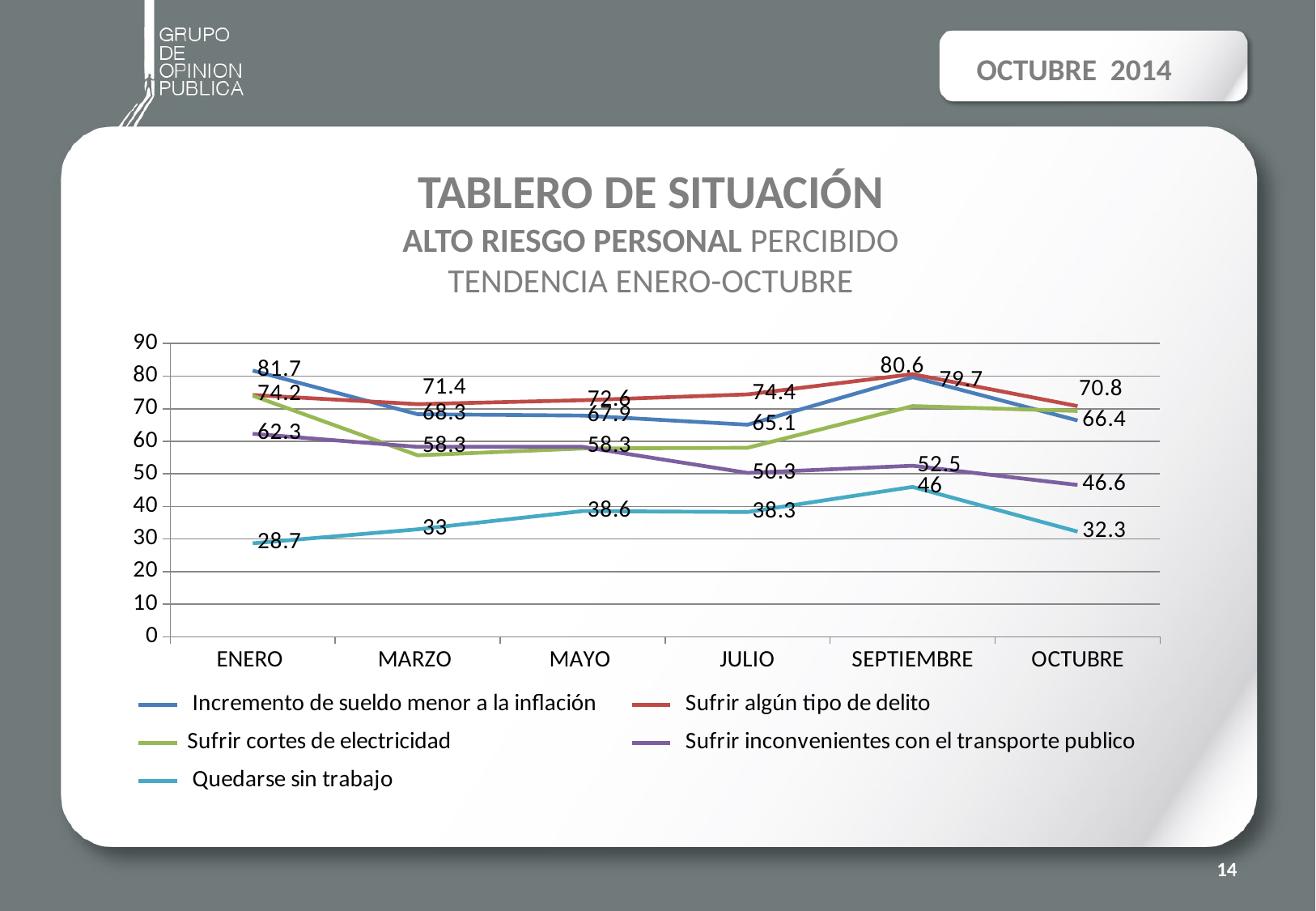
What kind of chart is shown on the slide? Line chart What is the value for Quedarse sin trabajo in SEPTIEMBRE? 46 In which month is Quedarse sin trabajo lowest? ENERO In JULIO, which is larger: Incremento de sueldo menor a la inflación or Sufrir algún tipo de delito? Sufrir algún tipo de delito What is the difference between the ENERO and OCTUBRE values for Incremento de sueldo menor a la inflación? 15.3 How many months are shown on the x axis? 6 What is the value for Incremento de sueldo menor a la inflación in ENERO? 81.7 How many series does the legend list? 5 Is the value for Sufrir cortes de electricidad in SEPTIEMBRE greater or less than 60? greater What is the value for Sufrir inconvenientes con el transporte publico in OCTUBRE? 46.6 In which month is Quedarse sin trabajo highest? SEPTIEMBRE What is the value for Sufrir algún tipo de delito in OCTUBRE? 70.8